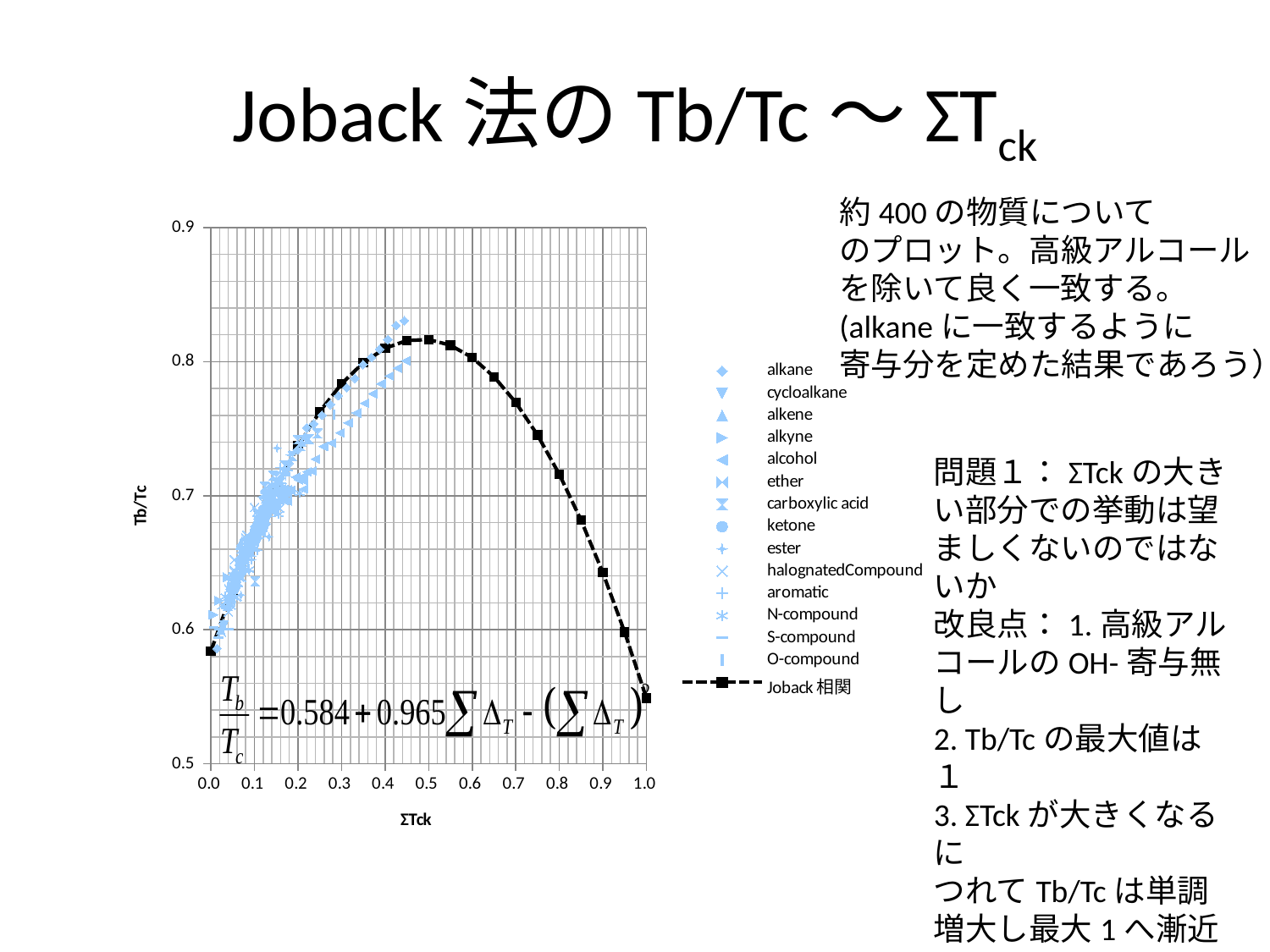
What is the label of the x axis of the chart? ΣTck Is the value of the Joback 相関 line at ΣTck = 0.0 greater or less than 0.6? less Is the value of the Joback 相関 line at ΣTck = 1.0 greater or less than 0.6? less What kind of chart is shown on the slide? scatter chart Is the value of the Joback 相関 line at ΣTck = 0.8 greater or less than 0.7? greater Does the Joback 相関 line rise or fall as ΣTck increases from 0.0 to 0.4? rise Which legend entry is drawn as a dashed black line with square markers? Joback 相関 How many series does the chart's legend list? 15 Which of the two is larger: the Joback 相関 value at ΣTck = 0.5 or at ΣTck = 0.9? ΣTck = 0.5 Does the Joback 相関 line rise or fall as ΣTck increases from 0.6 to 1.0? fall What is the label of the y axis of the chart? Tb/Tc